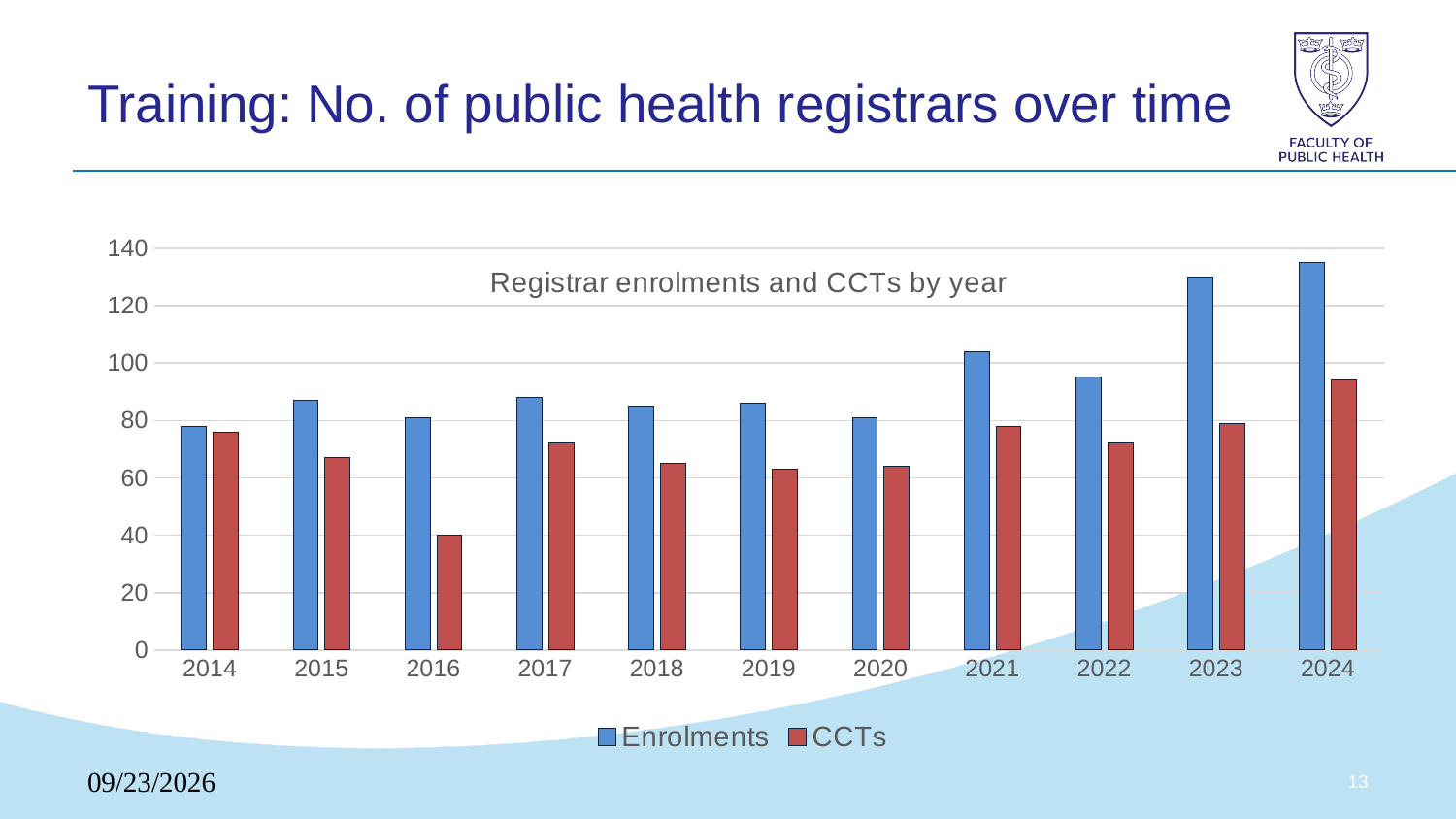
Is the value for Enrolments in 2023 greater or less than 120? greater What is the title of the chart? Registrar enrolments and CCTs by year Which year has the highest number of Enrolments? 2024 Is the value for Enrolments in 2021 greater or less than 100? greater Which is larger in 2016, Enrolments or CCTs? Enrolments What kind of chart is shown on the slide? bar chart How many years are shown on the x axis? 11 How many series does the legend list? 2 Which year has the lowest number of CCTs? 2016 Do Enrolments generally rise or fall from 2020 to 2024? rise Is the value for CCTs in 2019 greater or less than 80? less Which year has the highest number of CCTs? 2024